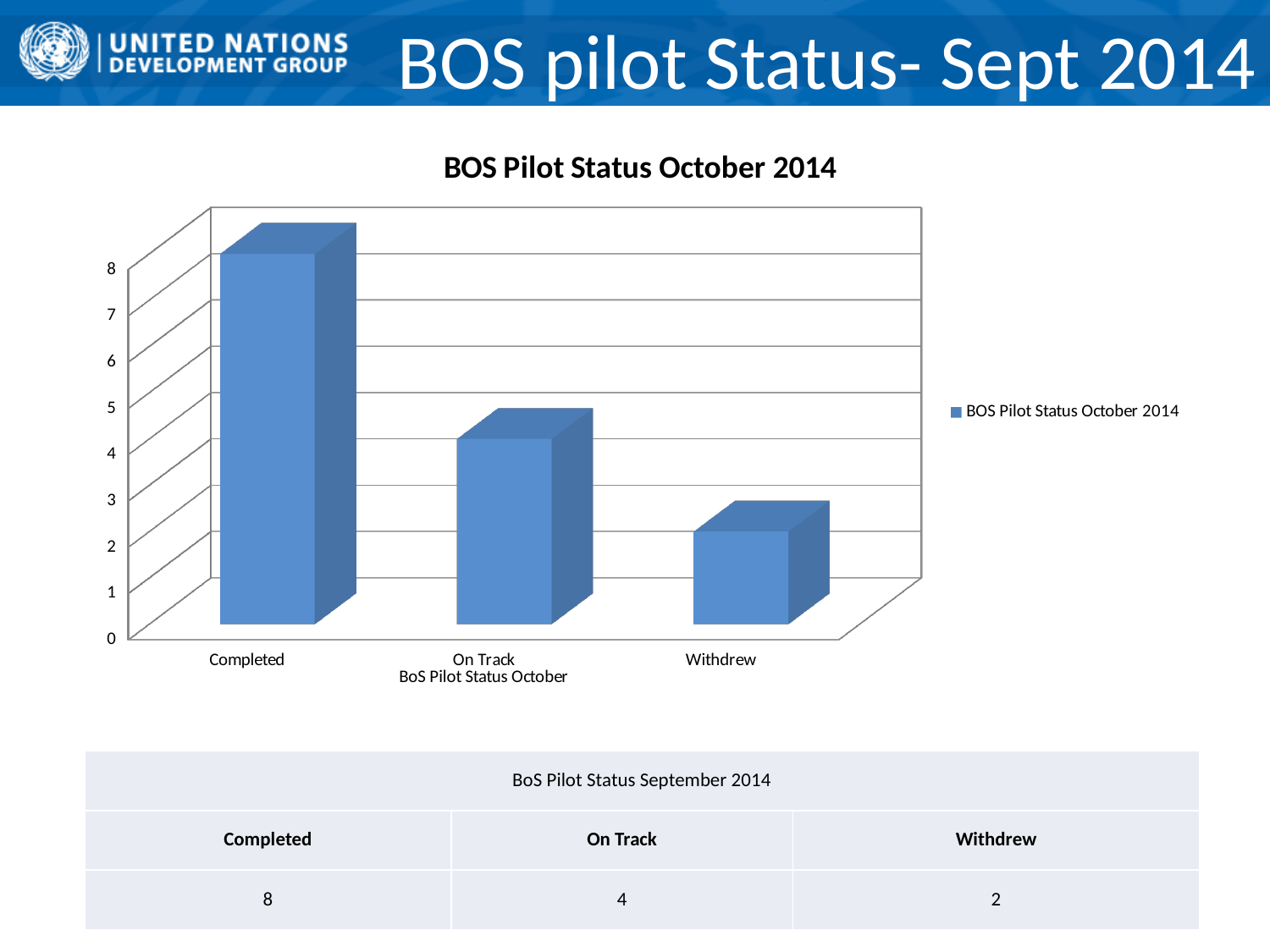
Is the value for Completed greater or less than 7? greater Is the value for Withdrew greater or less than 3? less What is the title of the chart? BOS Pilot Status October 2014 Which is larger in the chart, the value for On Track or the value for Withdrew? On Track How many categories are shown on the x axis of the chart? 3 Which category has the highest bar in the chart? Completed Which is larger in the chart, the value for Completed or the value for On Track? Completed What kind of chart is shown on the slide? bar chart Is the value for On Track greater or less than 5? less How many series does the chart legend list? 1 Do the bar values rise or fall from left to right across the x axis? fall Which category has the lowest bar in the chart? Withdrew